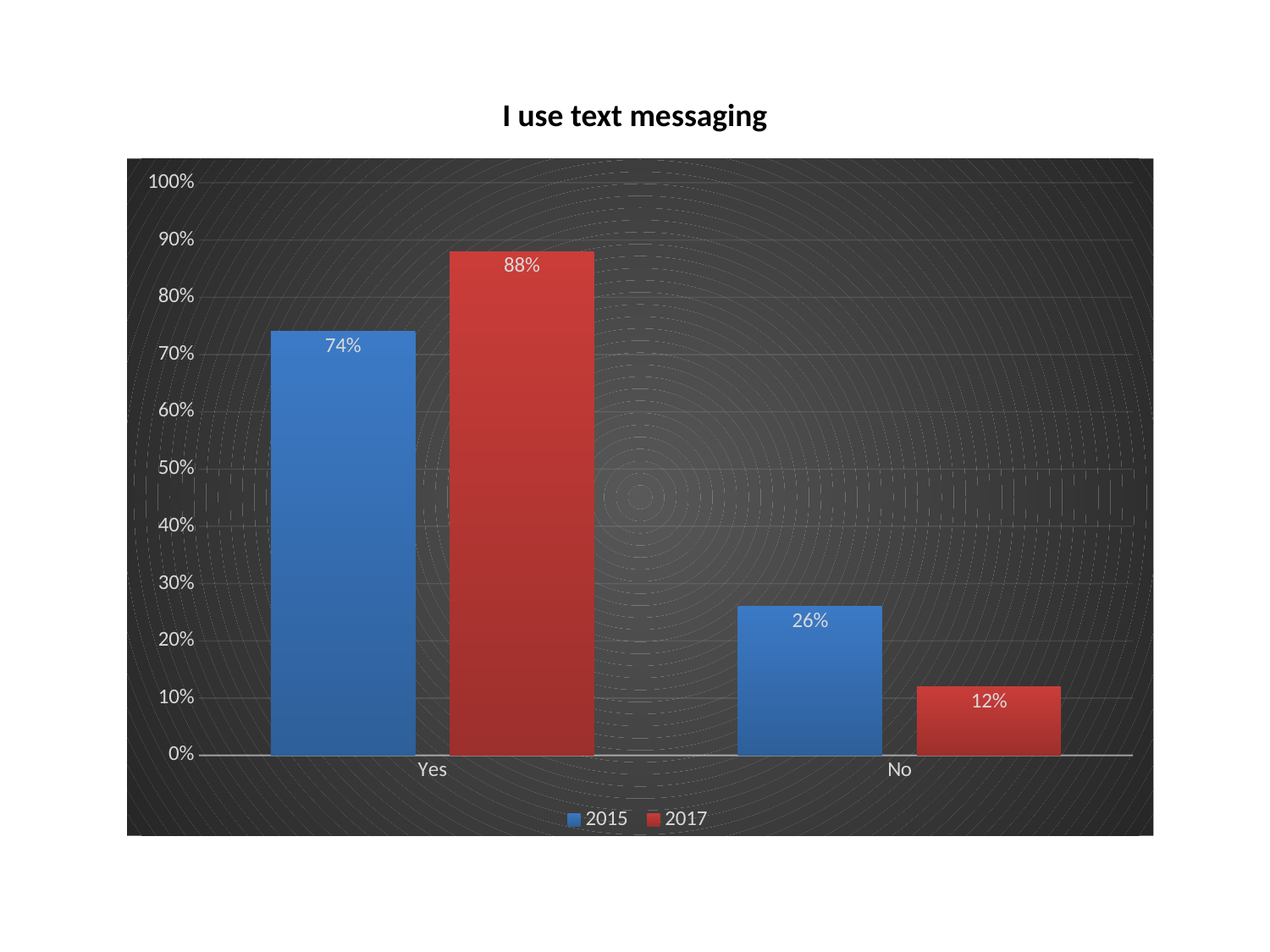
How many categories are shown on the x axis? 2 What is the difference between the 2017 and 2015 values for 'Yes'? 14% What is the value for 'No' in the 2015 series? 26% What is the value for 'Yes' in the 2015 series? 74% How many series does the legend list? 2 What is the value for 'No' in the 2017 series? 12% Which bar has the highest value on the chart? Yes, 2017 Which bar has the lowest value on the chart? No, 2017 What is the title of the chart? I use text messaging What is the difference between the 2015 and 2017 values for 'No'? 14% What is the value for 'Yes' in the 2017 series? 88% Which is larger for 'No': the 2015 value or the 2017 value? 2015